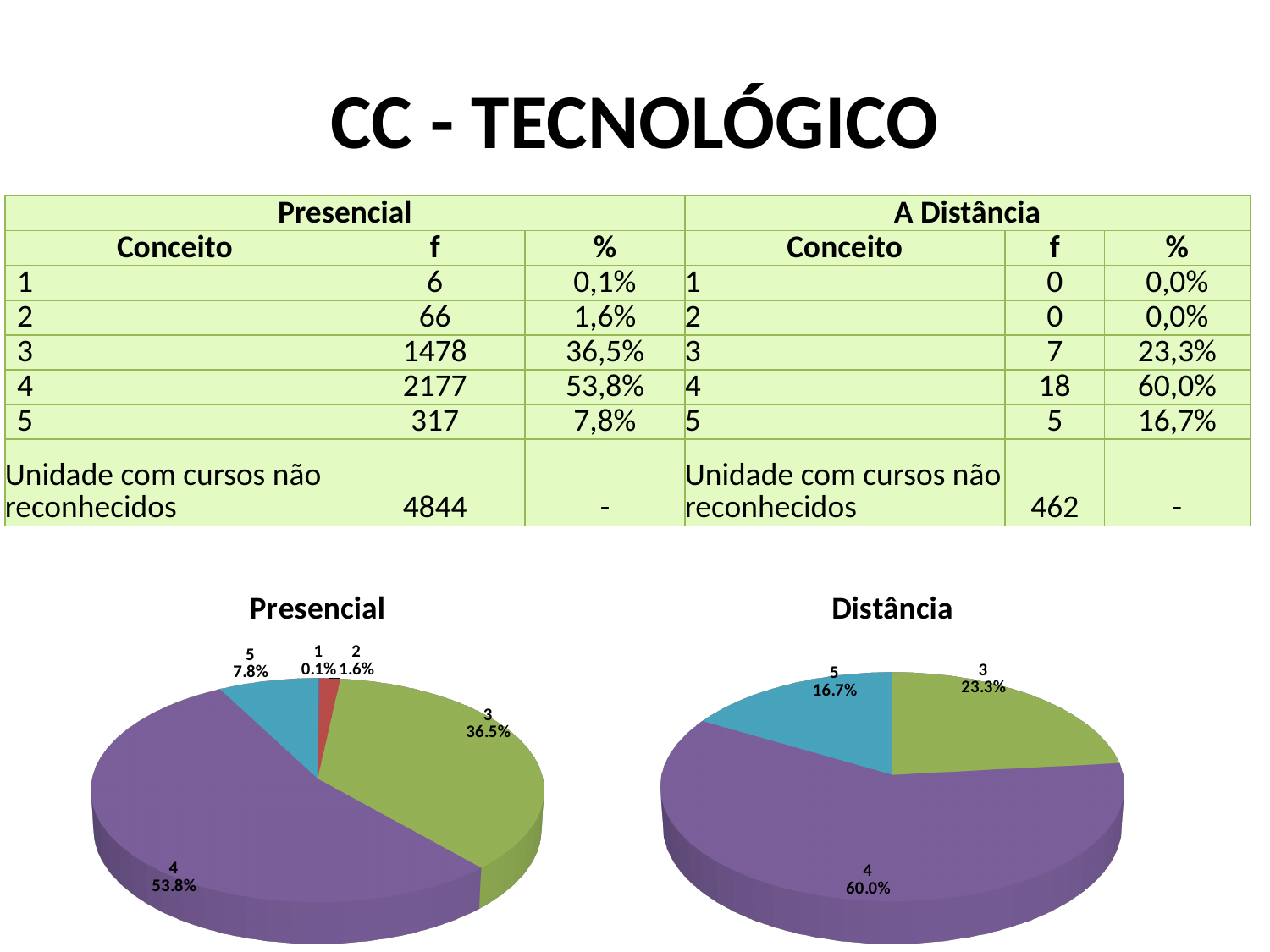
In the "Distância" pie chart, which is larger, the slice for concept 3 or the slice for concept 5? 3 In the "Distância" pie chart, what share does concept 5 have? 16.7% In the "Presencial" pie chart, what share does concept 4 have? 53.8% In the "Presencial" pie chart, what share does concept 3 have? 36.5% What kind of chart is the "Presencial" chart? pie chart In the "Presencial" pie chart, which concept has the largest slice? 4 In the "Distância" pie chart, what share does concept 4 have? 60.0% In the "Presencial" pie chart, what is the difference between the shares of concept 4 and concept 3? 17.3% How many slices are labelled in the "Presencial" pie chart? 5 How many slices are labelled in the "Distância" pie chart? 3 In the "Presencial" pie chart, which concept has the smallest slice? 1 In the "Distância" pie chart, what colour is the slice for concept 4? purple